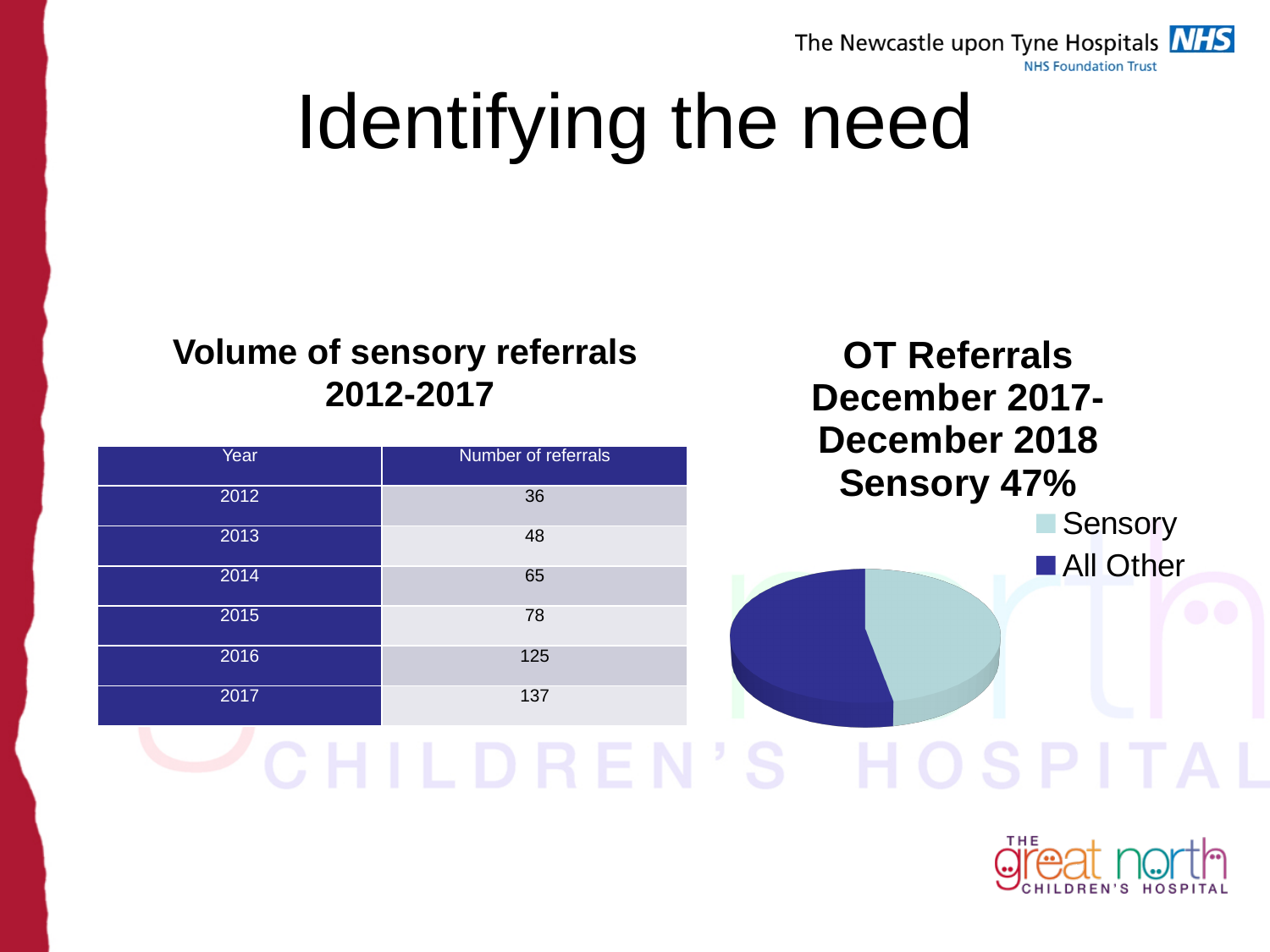
In the pie chart, which category has the largest share? All Other How many slices does the pie chart have? 2 What kind of chart is shown on the right of the slide under the heading 'OT Referrals December 2017-December 2018'? pie chart How many series does the legend of the pie chart list? 2 Is the Sensory share in the pie chart greater or less than 50%? less In the pie chart, which category has the smallest share? Sensory What are the two legend entries of the pie chart? Sensory and All Other In the pie chart, what share of OT referrals is Sensory? 47% What period does the pie chart's heading say the OT referrals cover? December 2017-December 2018 In the pie chart, which slice is larger, Sensory or All Other? All Other